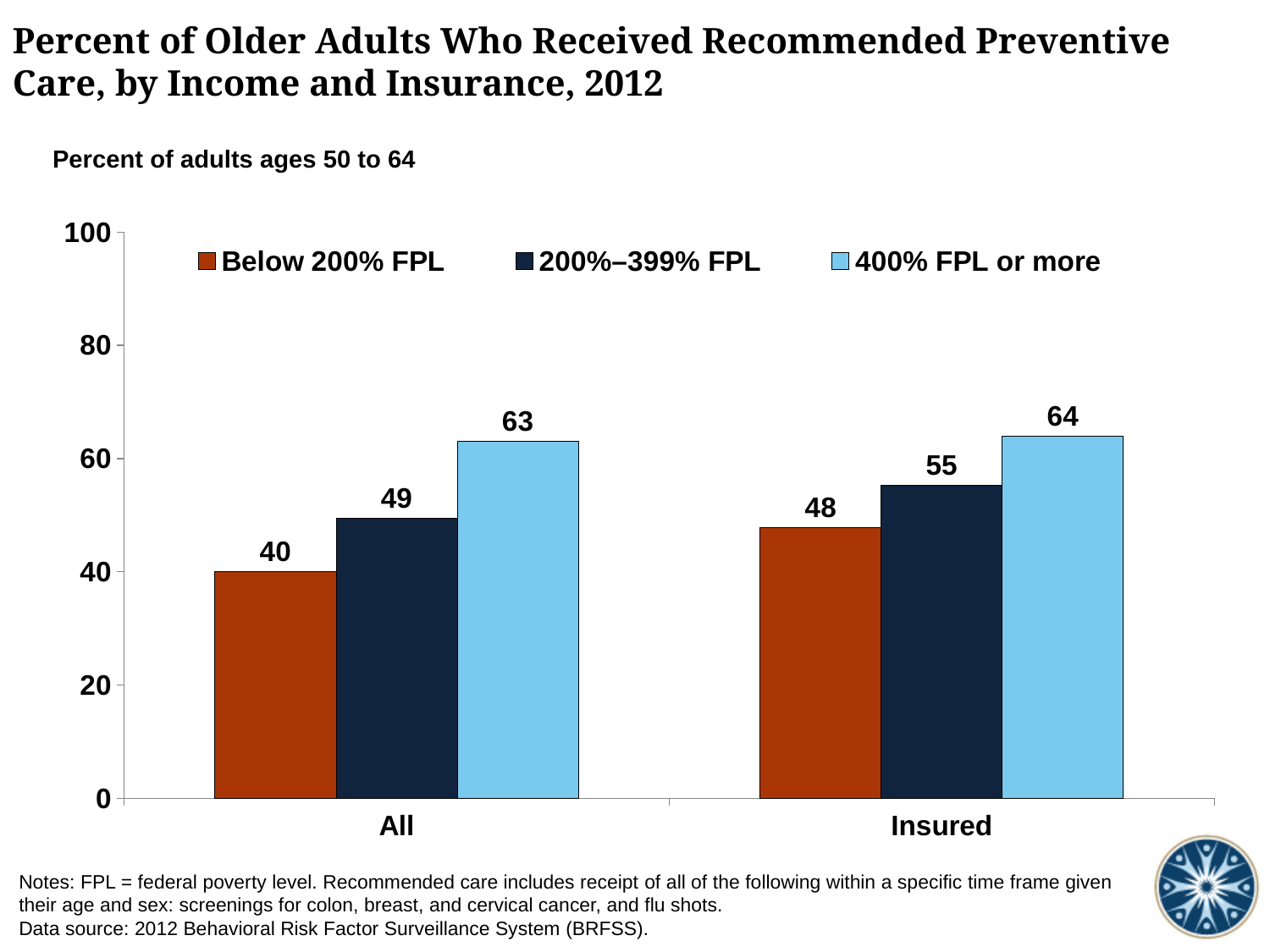
What is the difference between the Insured and All values for Below 200% FPL? 8 Which income group has the lowest value in the All category? Below 200% FPL Which income group has the highest value in the Insured category? 400% FPL or more Which is larger: the 200%–399% FPL value for All or for Insured? Insured How many series does the legend list? 3 What kind of chart is shown on the slide? Bar chart How many categories are shown on the x axis? 2 Is the value for Below 200% FPL in the Insured group greater or less than 60? less What is the value for 200%–399% FPL in the All group? 49 What is the difference between the 400% FPL or more and Below 200% FPL values in the All group? 23 What is the value for 400% FPL or more in the Insured group? 64 What percent of adults ages 50 to 64 with income below 200% FPL in the All group received recommended preventive care? 40